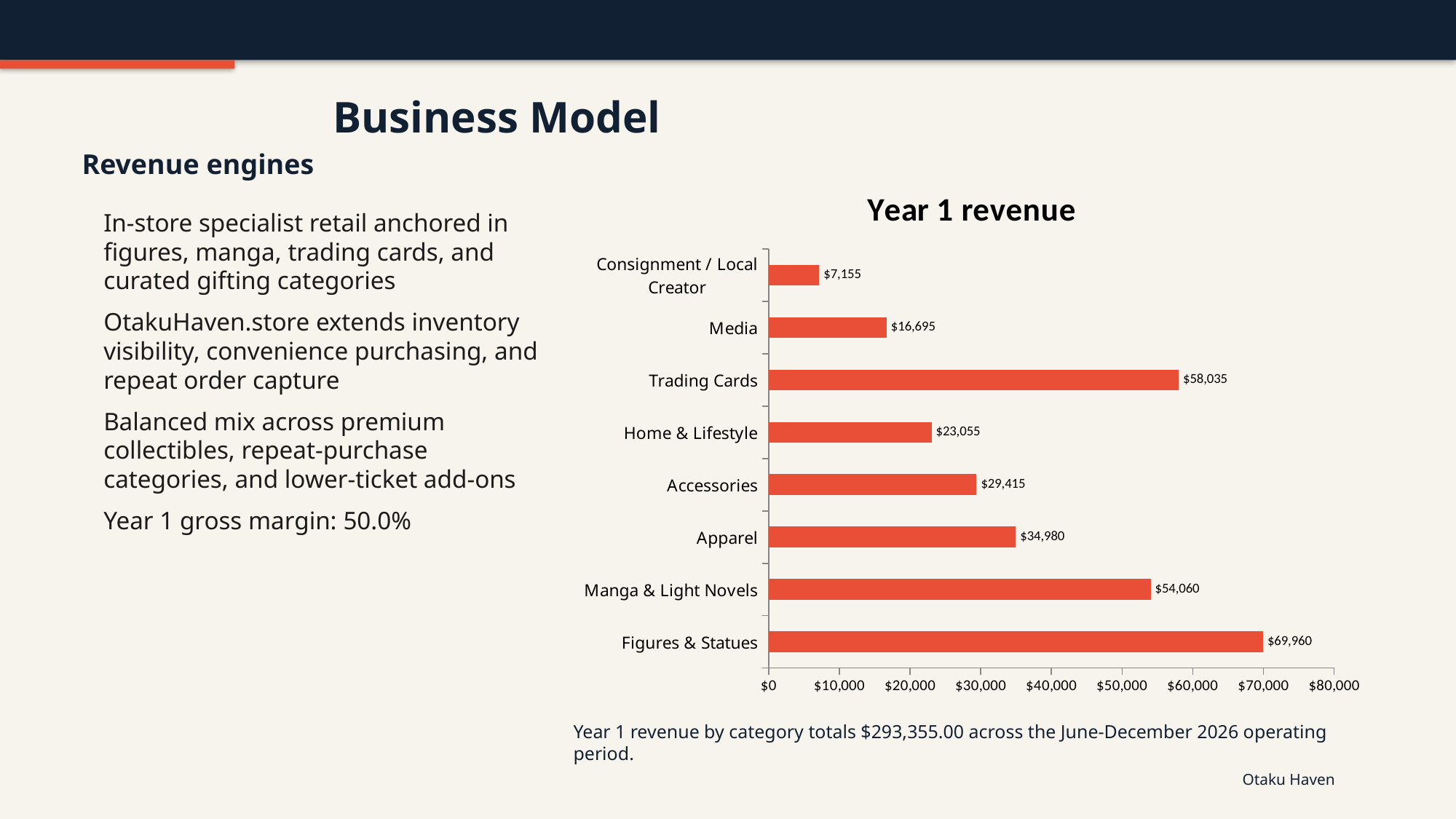
What kind of chart is used to show Year 1 revenue? Bar chart What is the Year 1 revenue for Consignment / Local Creator? $7,155 What is the Year 1 revenue for Media? $16,695 What is the title of the chart on the slide? Year 1 revenue Which category has the lowest Year 1 revenue? Consignment / Local Creator How many categories are shown in the Year 1 revenue chart? 8 Which category has the highest Year 1 revenue? Figures & Statues What is the Year 1 revenue for Trading Cards? $58,035 Is the Year 1 revenue for Manga & Light Novels greater or less than $50,000? greater What is the difference in Year 1 revenue between Figures & Statues and Manga & Light Novels? $15,900 Which has higher Year 1 revenue, Home & Lifestyle or Accessories? Accessories What is the difference in Year 1 revenue between Apparel and Accessories? $5,565